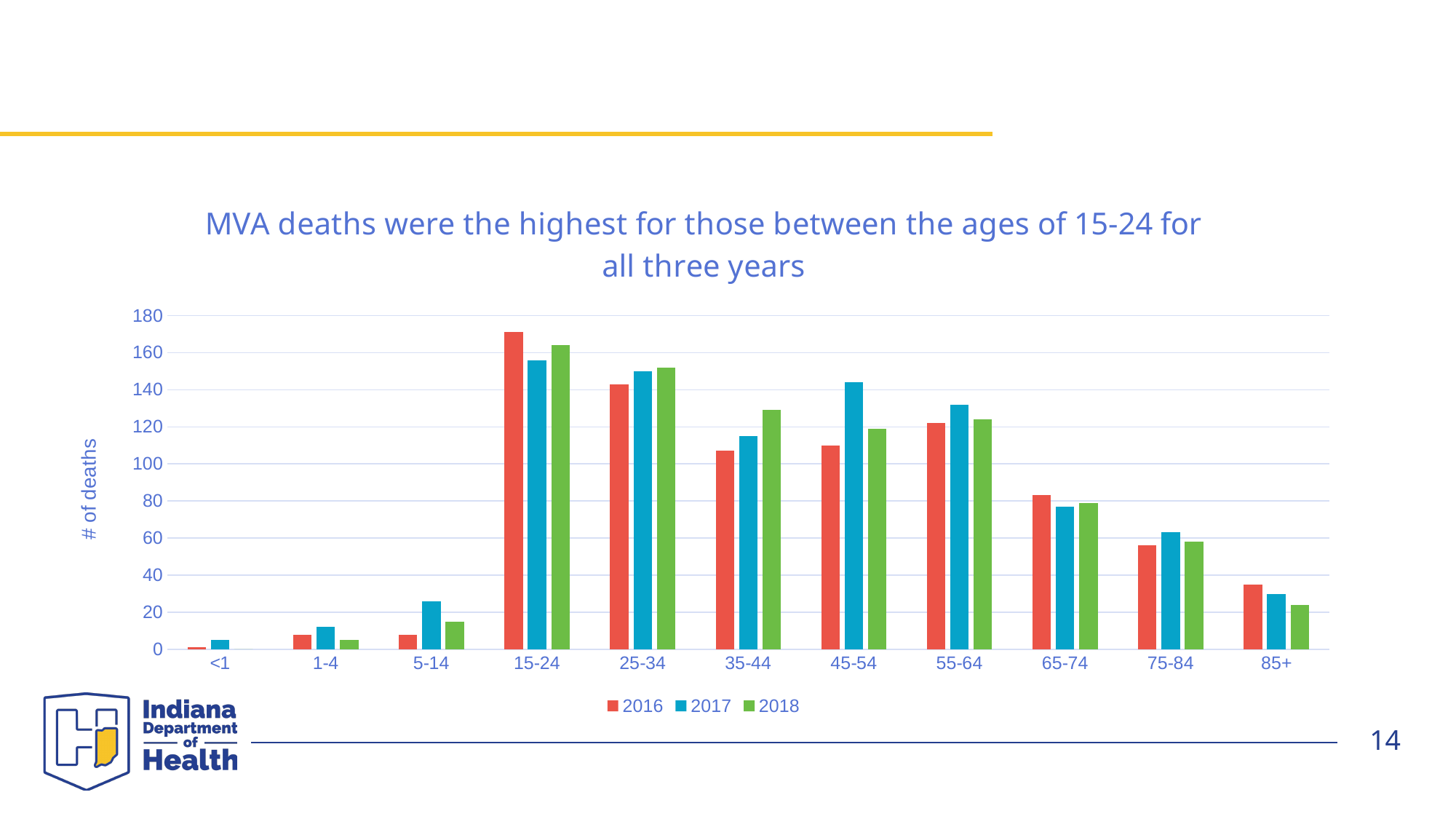
How many age-group categories are shown on the x axis? 11 Do the 2016 values rise or fall from the 65-74 age group to the 85+ age group? fall Is the 2016 value for the 15-24 age group greater or less than 160? greater Which age group has the highest number of deaths for 2018? 15-24 For the 45-54 age group, which year has more deaths, 2016 or 2017? 2017 Which age group has the lowest number of deaths for 2017? <1 How many series does the legend list? 3 What kind of chart is shown on the slide? bar chart Is the 2018 value for the 85+ age group greater or less than 40? less Which age group has the highest number of deaths for 2016? 15-24 For the 35-44 age group, which year has more deaths, 2016 or 2018? 2018 Is the 2017 value for the 45-54 age group greater or less than 120? greater